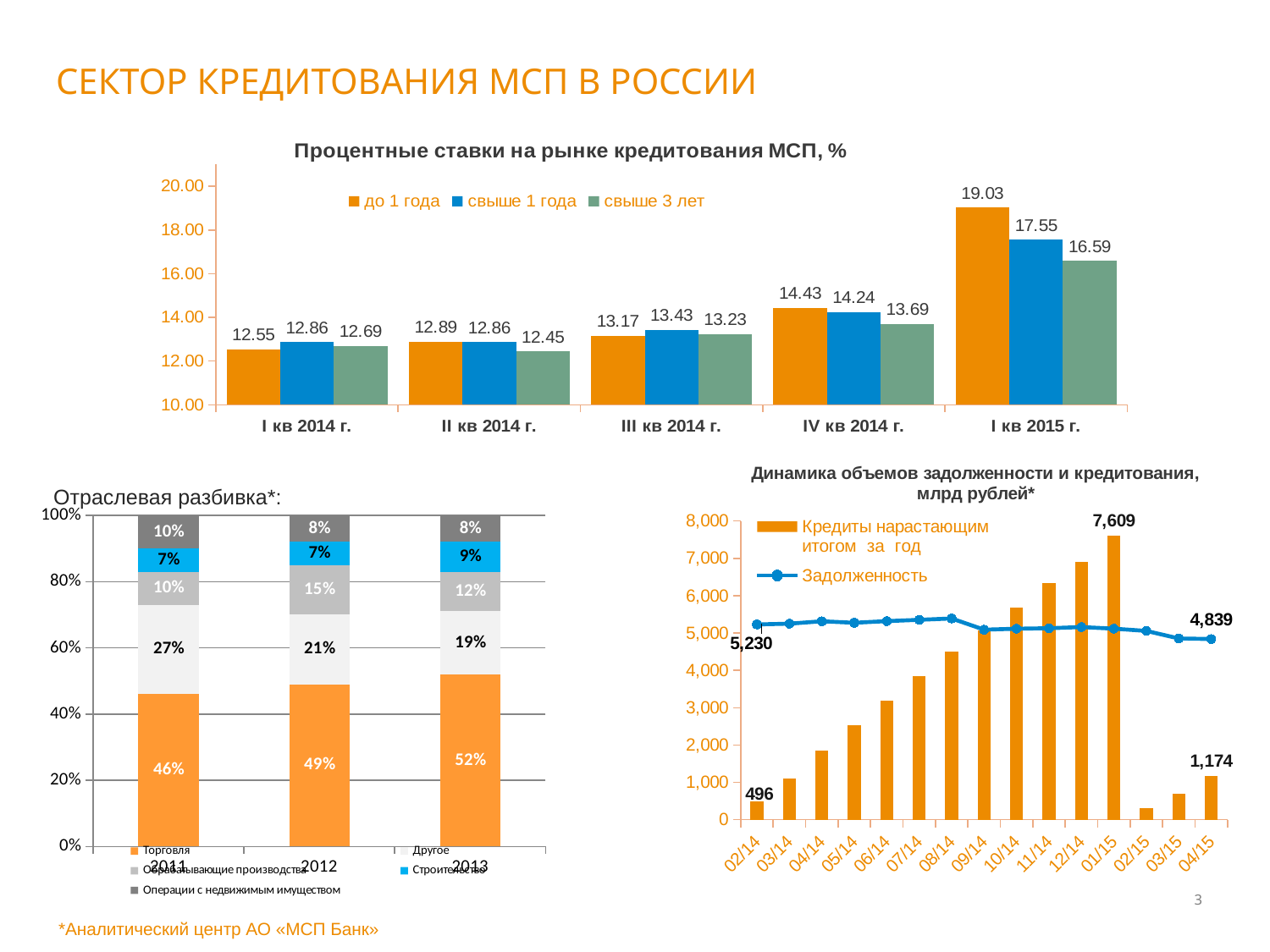
In the chart 'Динамика объемов задолженности и кредитования, млрд рублей*', how many months are shown on the x axis? 15 In the chart 'Процентные ставки на рынке кредитования МСП, %', what is the value for 'до 1 года' in I кв 2015 г.? 19.03 In the chart 'Отраслевая разбивка*', which year has the lowest share for 'Торговля'? 2011 In the chart 'Динамика объемов задолженности и кредитования, млрд рублей*', what is the value of 'Кредиты нарастающим итогом за год' in 01/15? 7,609 In the chart 'Отраслевая разбивка*', what is the share of 'Торговля' in 2013? 52% In the chart 'Отраслевая разбивка*', what kind of chart is shown? stacked bar chart In the chart 'Процентные ставки на рынке кредитования МСП, %', what is the value for 'свыше 3 лет' in II кв 2014 г.? 12.45 In the chart 'Процентные ставки на рынке кредитования МСП, %', what is the difference between the 'до 1 года' values in I кв 2015 г. and IV кв 2014 г.? 4.60 In the chart 'Динамика объемов задолженности и кредитования, млрд рублей*', what is the value of 'Задолженность' in 04/15? 4,839 In the chart 'Процентные ставки на рынке кредитования МСП, %', how many series does the legend list? 3 In the chart 'Процентные ставки на рынке кредитования МСП, %', does the 'до 1 года' value rise or fall from I кв 2014 г. to I кв 2015 г.? rise In the chart 'Процентные ставки на рынке кредитования МСП, %', which quarter has the highest value for 'свыше 1 года'? I кв 2015 г.